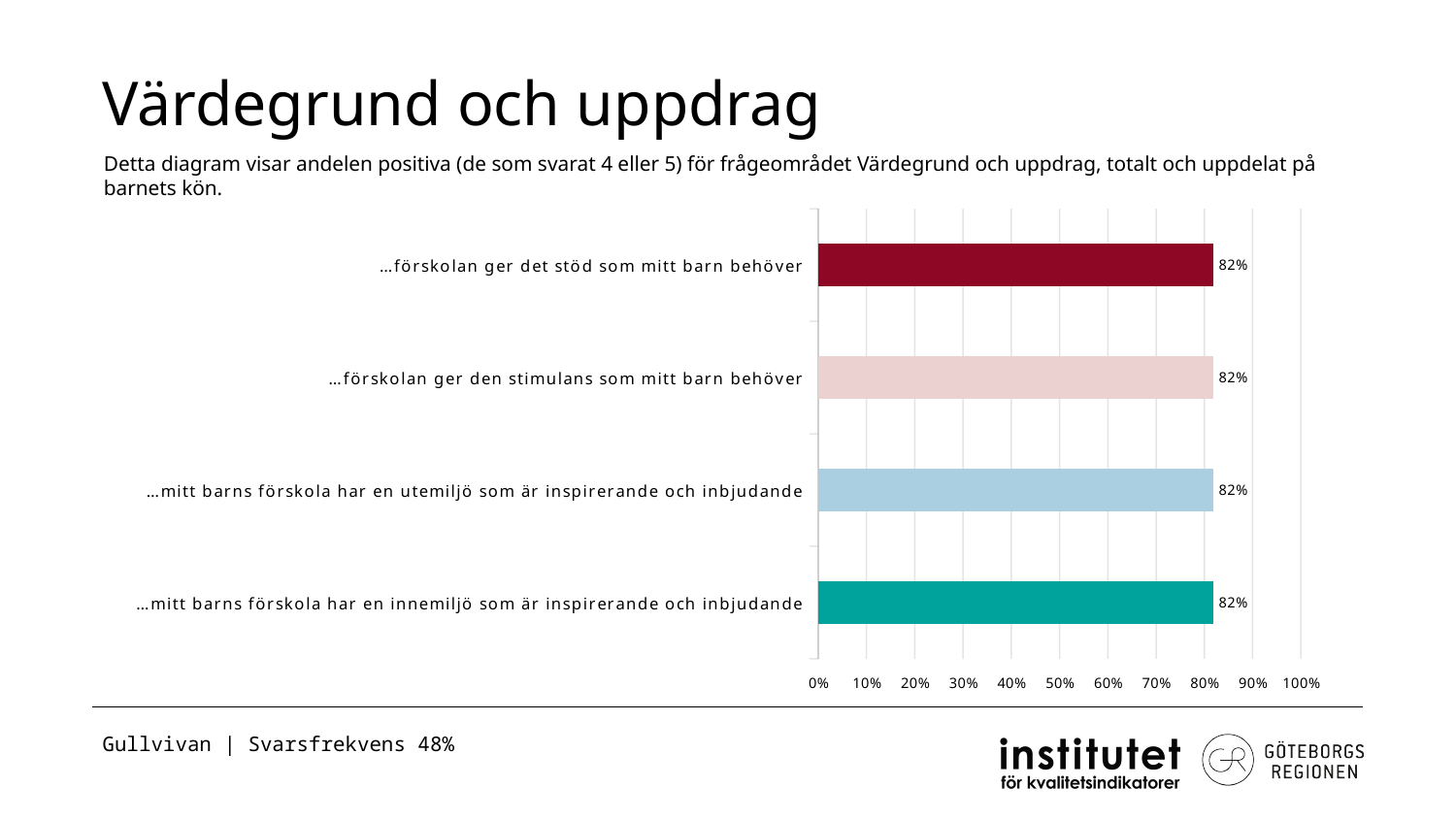
What is the difference between the values for "…förskolan ger det stöd som mitt barn behöver" and "…mitt barns förskola har en utemiljö som är inspirerande och inbjudande"? 0% What is the title of the slide containing the chart? Värdegrund och uppdrag What is the value for "…förskolan ger det stöd som mitt barn behöver"? 82% What kind of chart is shown on the slide? Bar chart How many categories are shown in the chart? 4 What is the value for "…mitt barns förskola har en utemiljö som är inspirerande och inbjudande"? 82% Is the value for "…förskolan ger det stöd som mitt barn behöver" greater or less than 70%? greater What is the maximum value shown on the x axis of the chart? 100% What is the value for "…mitt barns förskola har en innemiljö som är inspirerande och inbjudande"? 82% What is the value for "…förskolan ger den stimulans som mitt barn behöver"? 82% Is the value for "…mitt barns förskola har en innemiljö som är inspirerande och inbjudande" greater or less than 90%? less